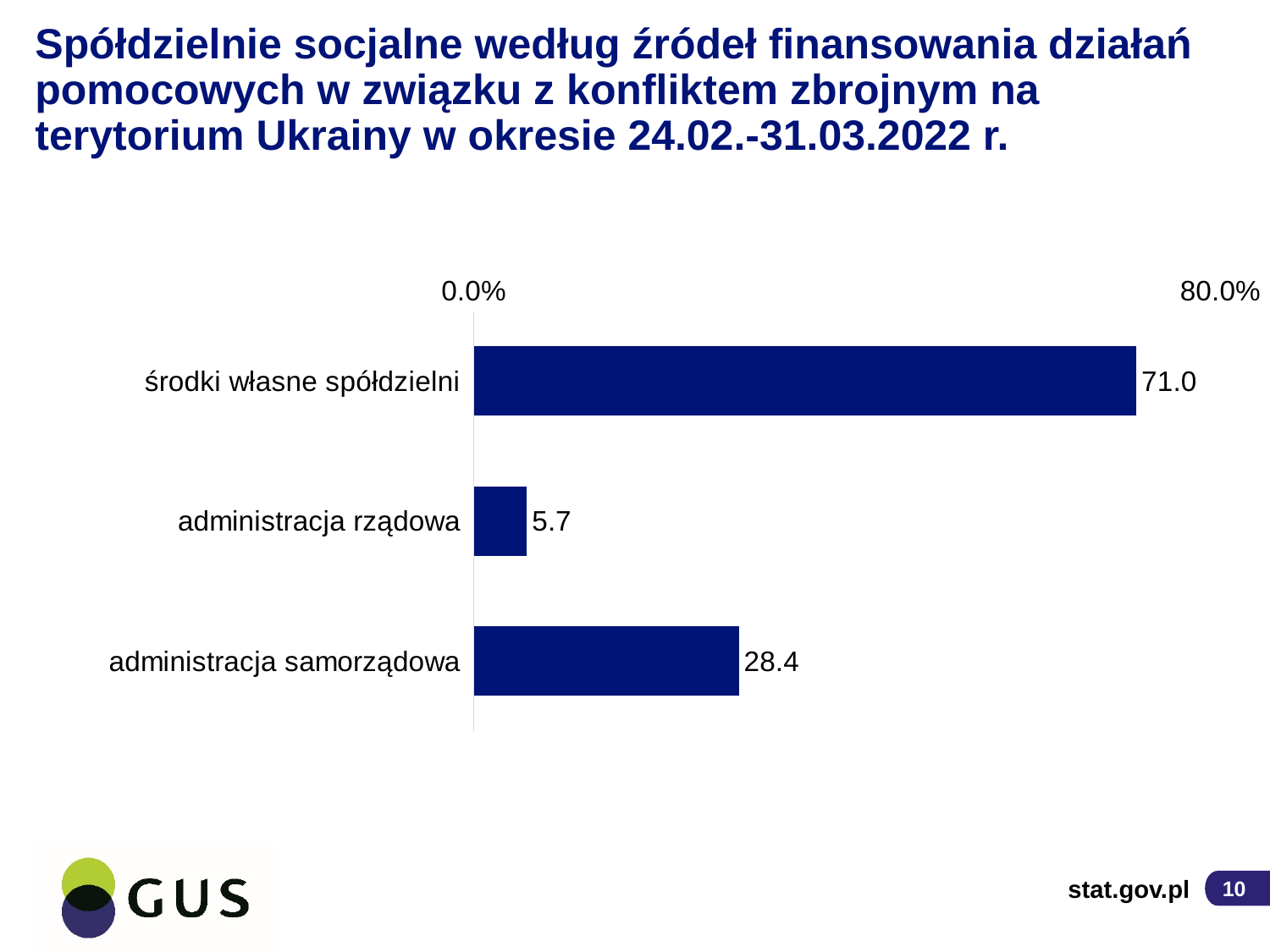
What is the value for środki własne spółdzielni? 71.0 What is the maximum value shown on the chart's axis? 80.0% Which category has the highest value? środki własne spółdzielni How many categories are shown in the chart? 3 What colour are the bars in the chart? dark blue What is the value for administracja rządowa? 5.7 What is the difference between the values for środki własne spółdzielni and administracja samorządowa? 42.6 What kind of chart is shown on the slide? bar chart What is the difference between the values for administracja samorządowa and administracja rządowa? 22.7 Which is larger, the value for administracja samorządowa or administracja rządowa? administracja samorządowa What is the value for administracja samorządowa? 28.4 Which category has the lowest value? administracja rządowa